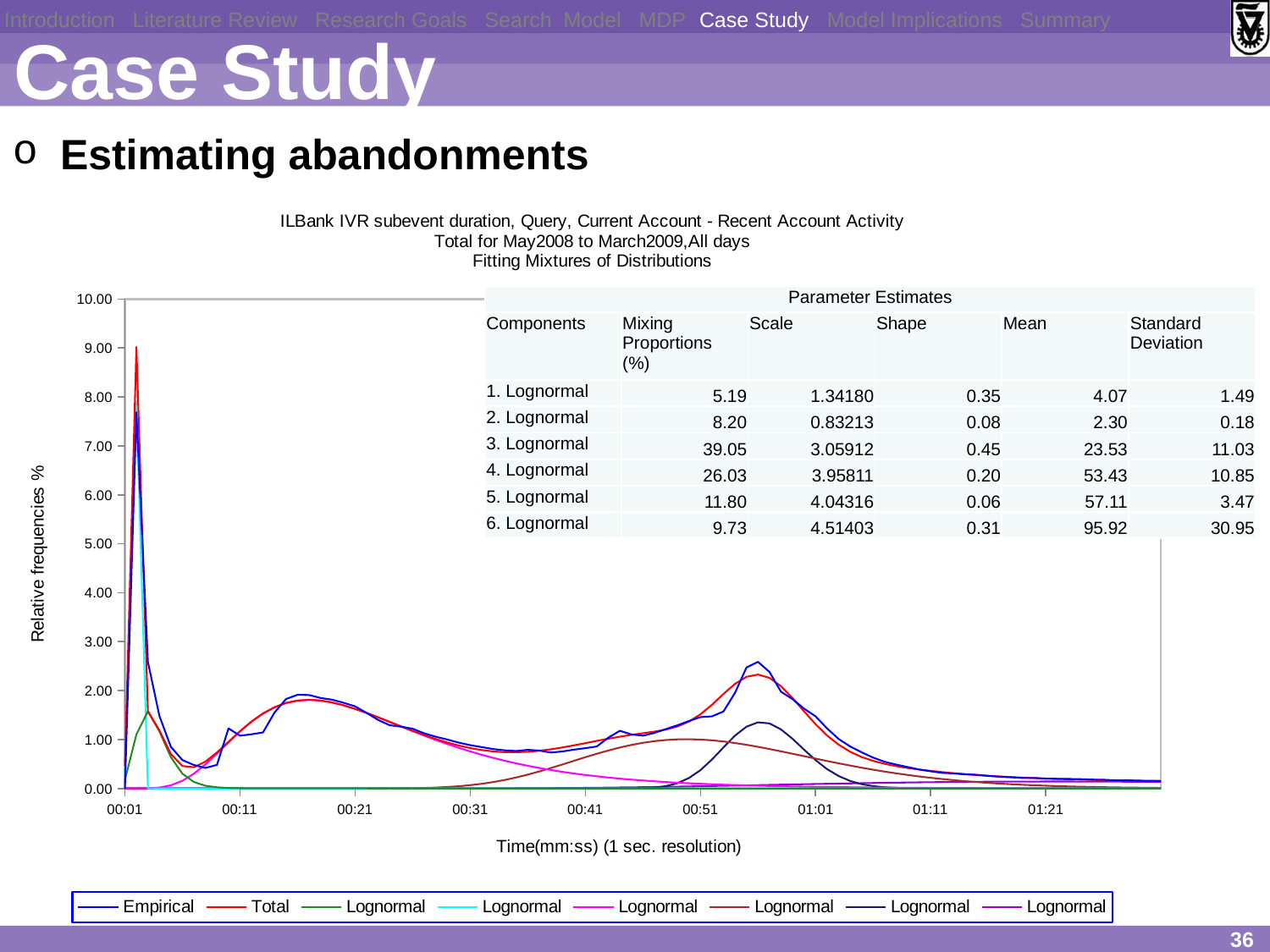
In the Parameter Estimates table, which has the larger Shape value, 1. Lognormal or 3. Lognormal? 3. Lognormal How many series does the chart legend list? 8 In the Parameter Estimates table, what is the Mixing Proportions (%) value for 3. Lognormal? 39.05 What is the label of the x axis of the chart? Time(mm:ss) (1 sec. resolution) In the Parameter Estimates table, what is the Mean for 6. Lognormal? 95.92 In the Parameter Estimates table, what is the difference between the Mean of 5. Lognormal and the Mean of 4. Lognormal? 3.68 What kind of chart is shown on the slide? line chart How many lognormal components are listed in the Parameter Estimates table? 6 Is the peak value of the Total line near 00:02 greater or less than 8.00? greater What is the label of the y axis of the chart? Relative frequencies % In the Parameter Estimates table, which component has the highest Mixing Proportions (%)? 3. Lognormal In the Parameter Estimates table, which component has the lowest Standard Deviation? 2. Lognormal